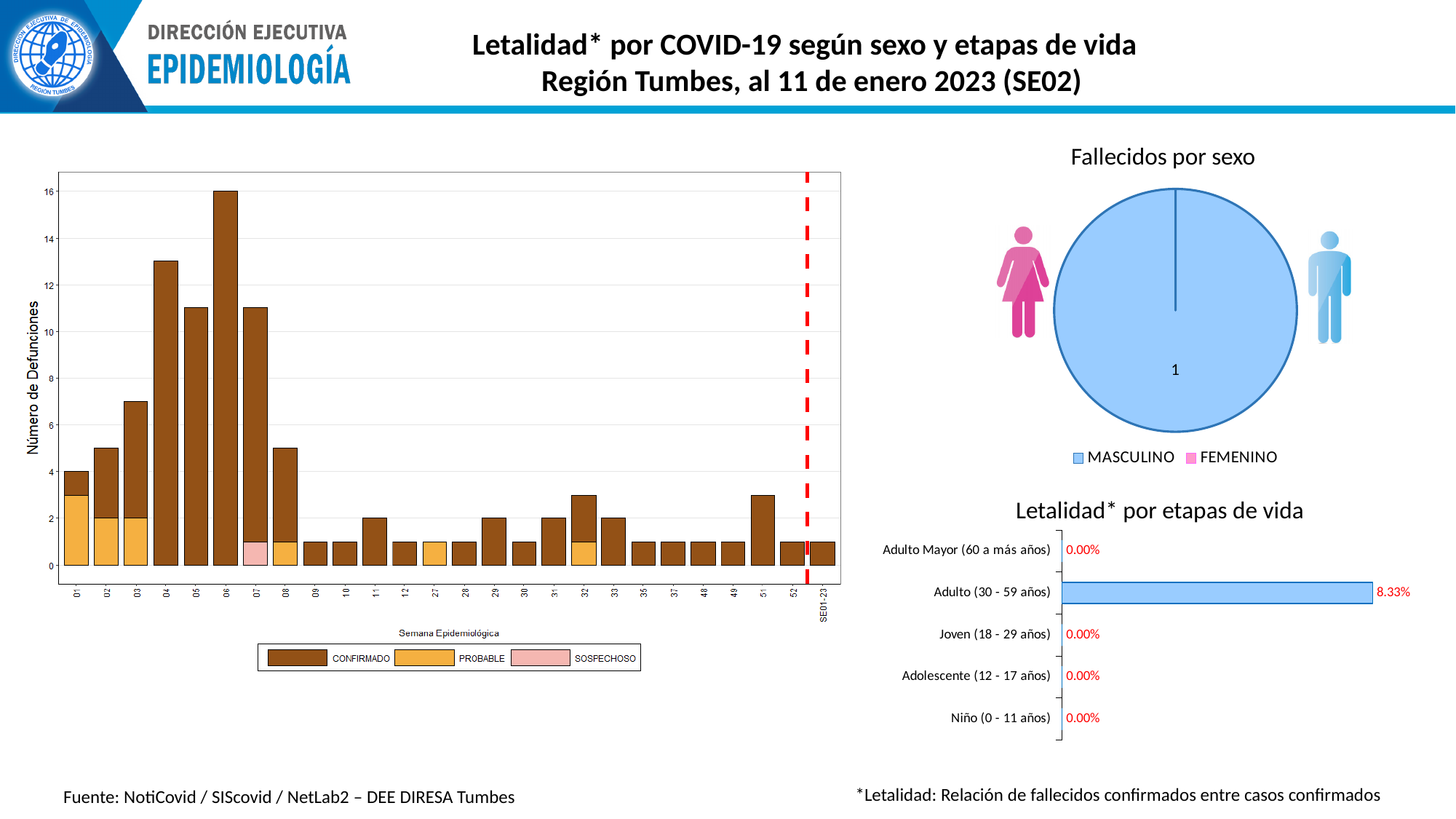
In the 'Letalidad* por etapas de vida' chart, which age group has the highest value? Adulto (30 - 59 años) In the 'Letalidad* por etapas de vida' chart, what is the value for Adulto (30 - 59 años)? 8.33% In the bar chart on the left, is the total number of deaths for week 03 greater or less than 8? less How many age-group categories are shown in the 'Letalidad* por etapas de vida' chart? 5 How many series does the legend of the 'Fallecidos por sexo' chart list? 2 What kind of chart is 'Fallecidos por sexo'? Pie chart In the 'Fallecidos por sexo' chart, which sex has the larger share? MASCULINO In the 'Letalidad* por etapas de vida' chart, what is the difference between the values for Adulto (30 - 59 años) and Joven (18 - 29 años)? 8.33% In the bar chart on the left, how many series does the legend list? 3 In the bar chart on the left, is the total number of deaths for week 04 greater or less than 12? greater In the bar chart on the left (Número de Defunciones by Semana Epidemiológica), which epidemiological week has the highest number of deaths? 06 In the 'Letalidad* por etapas de vida' chart, what is the value for Adulto Mayor (60 a más años)? 0.00%